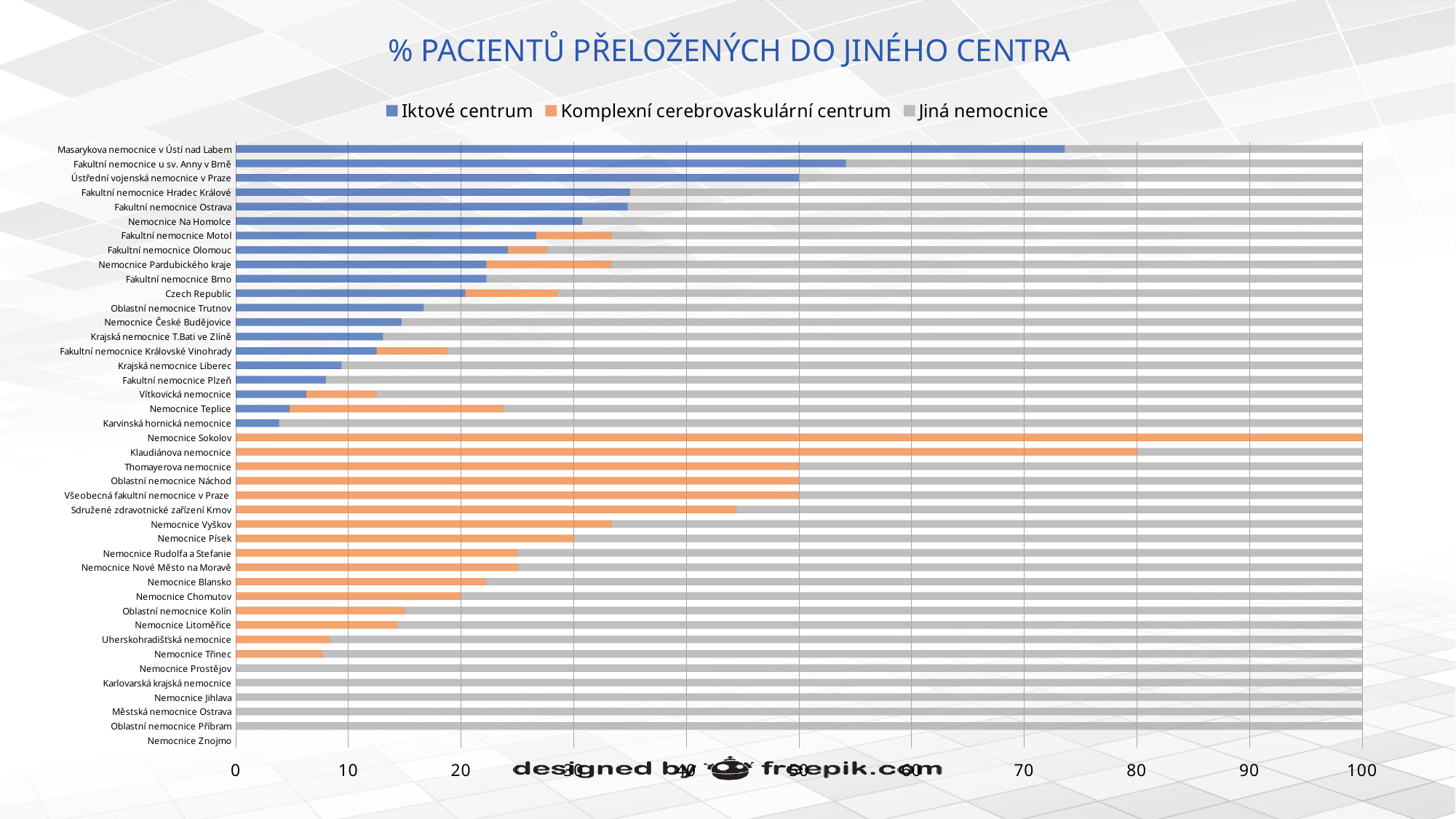
Is the Iktové centrum value for Karvinská hornická nemocnice greater or less than 10? less Which hospital has the highest share for Komplexní cerebrovaskulární centrum? Nemocnice Sokolov How many series does the legend list? 3 Is the Iktové centrum value for Masarykova nemocnice v Ústí nad Labem greater or less than 70? greater Is the Komplexní cerebrovaskulární centrum value for Nemocnice Třinec greater or less than 10? less What kind of chart is shown on the slide? Stacked horizontal bar chart Which series is shown in orange in the legend? Komplexní cerebrovaskulární centrum Which has the larger Iktové centrum share: Masarykova nemocnice v Ústí nad Labem or Fakultní nemocnice u sv. Anny v Brně? Masarykova nemocnice v Ústí nad Labem How many hospitals (categories) are listed on the vertical axis? 42 What is the title of the chart? % PACIENTŮ PŘELOŽENÝCH DO JINÉHO CENTRA Which hospital has the highest share for Iktové centrum? Masarykova nemocnice v Ústí nad Labem